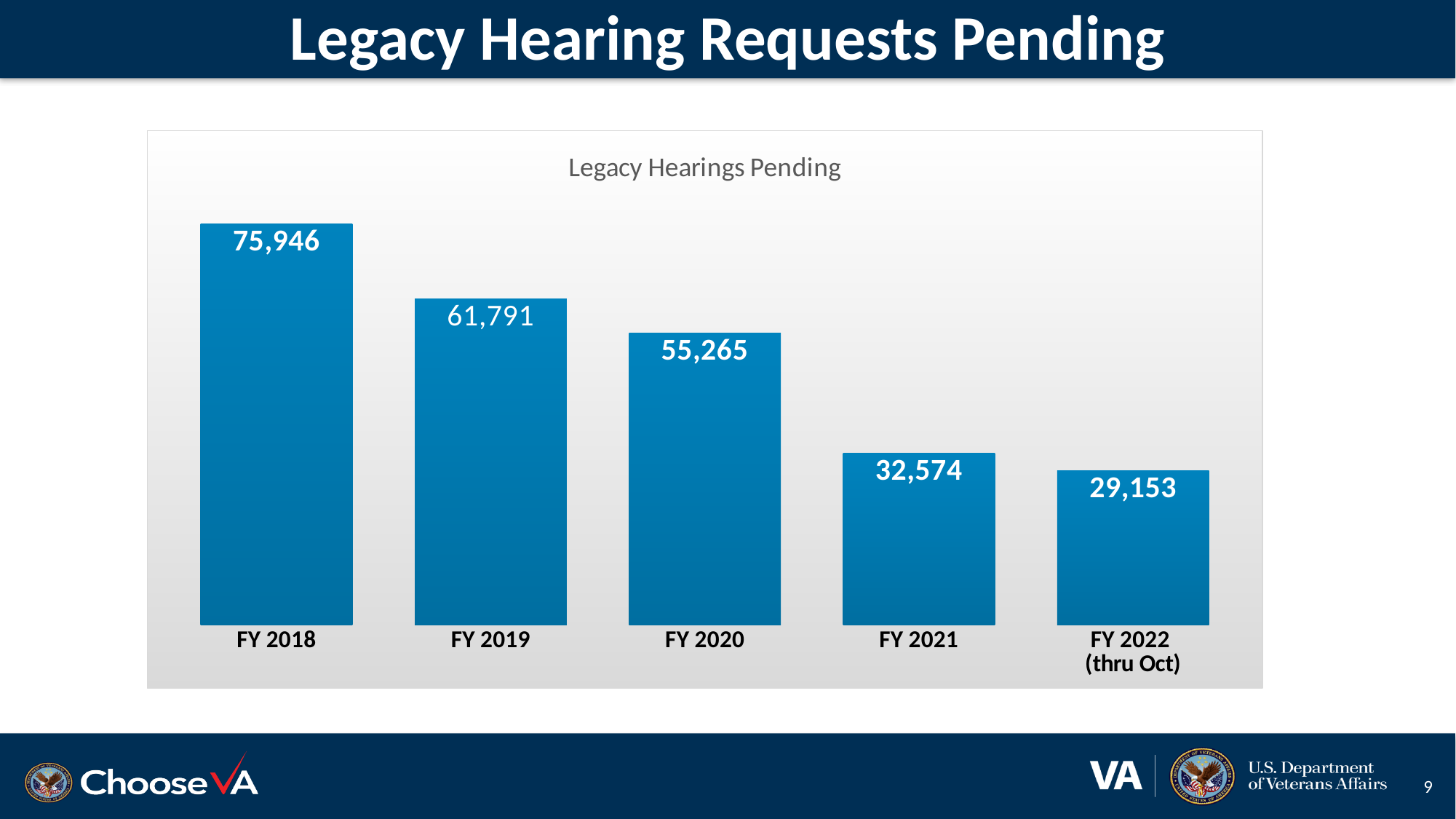
Which fiscal year has the highest number of legacy hearings pending? FY 2018 Which is larger, the value for FY 2019 or the value for FY 2021? FY 2019 What is the value for FY 2020? 55,265 What is the difference between the FY 2018 and FY 2019 values? 14,155 What is the value for FY 2022 (thru Oct)? 29,153 Do the values rise or fall from FY 2018 to FY 2022? Fall What is the difference between the FY 2020 and FY 2021 values? 22,691 What is the value for FY 2018? 75,946 What kind of chart is shown on the slide? Bar chart What is the title of the chart? Legacy Hearings Pending How many fiscal years are shown in the chart? 5 Which fiscal year has the lowest number of legacy hearings pending? FY 2022 (thru Oct)